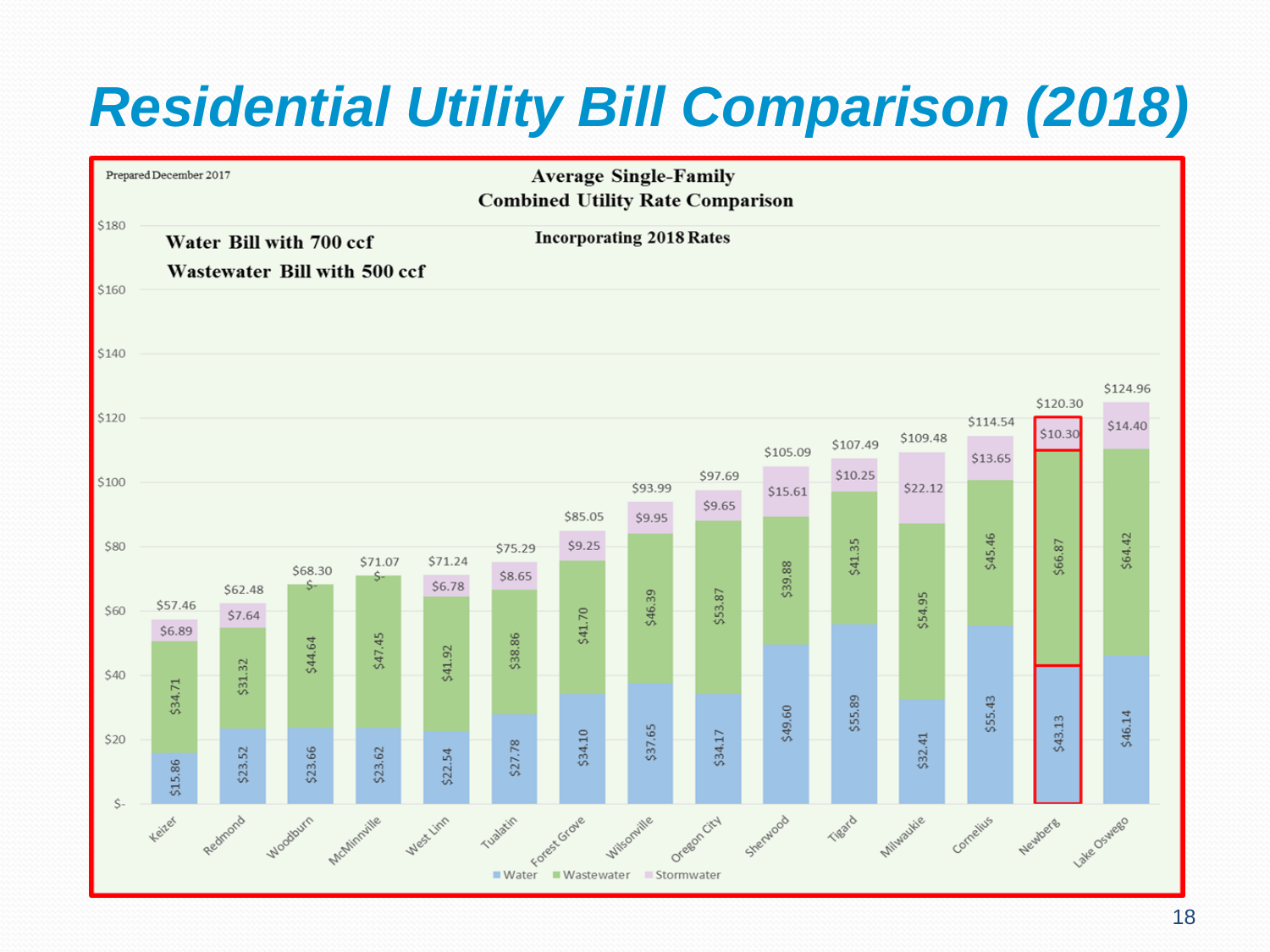
What type of chart is shown on the slide? Stacked bar chart Do the total bills generally rise or fall moving from left to right along the x axis? Rise What is the difference between the total bills for Lake Oswego and Newberg? $4.66 Which city has the lowest total combined utility bill? Keizer How many cities are shown on the x axis? 15 What is the total combined utility bill for Newberg? $120.30 What is the Stormwater value for Milwaukie? $22.12 What is the Wastewater value for Newberg? $66.87 Which city has the highest total combined utility bill? Lake Oswego Which city has the larger Water value, Tigard or Cornelius? Tigard What is the Water value for Keizer? $15.86 How many series does the legend list? 3